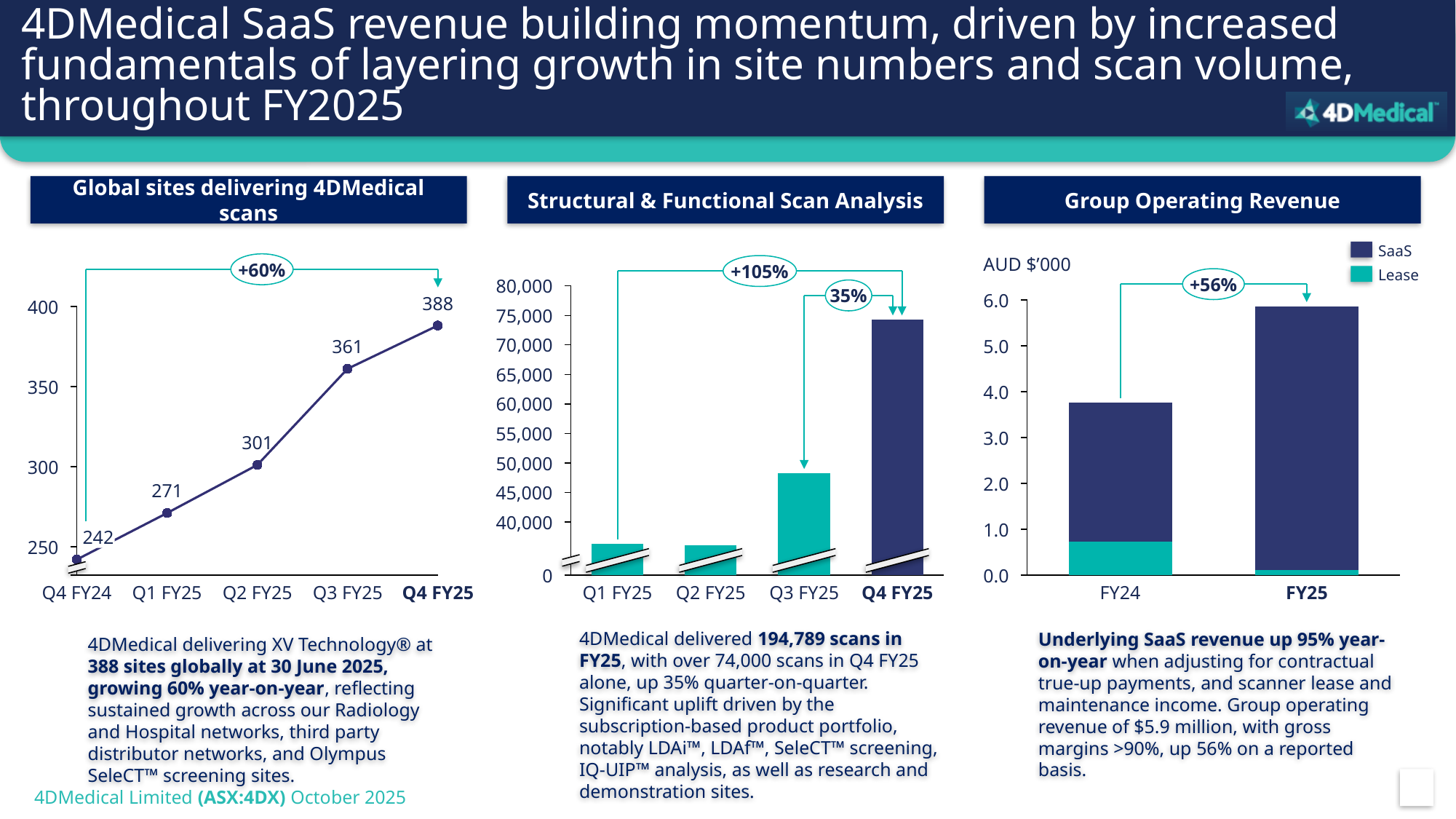
In the 'Global sites delivering 4DMedical scans' chart, what is the difference between the Q4 FY25 and Q4 FY24 values? 146 In the 'Global sites delivering 4DMedical scans' chart, what is the value for Q4 FY25? 388 What kind of chart is the 'Structural & Functional Scan Analysis' chart? bar chart In the 'Global sites delivering 4DMedical scans' chart, how many data points are plotted? 5 In the 'Global sites delivering 4DMedical scans' chart, do the values rise or fall from Q4 FY24 to Q4 FY25? rise In the 'Global sites delivering 4DMedical scans' chart, which quarter has the lowest value? Q4 FY24 In the 'Group Operating Revenue' chart, is the total for FY25 greater or less than 5.0? greater In the 'Structural & Functional Scan Analysis' chart, which quarter has the highest value? Q4 FY25 In the 'Structural & Functional Scan Analysis' chart, is the value for Q4 FY25 greater or less than 70,000? greater How many series does the legend of the 'Group Operating Revenue' chart list? 2 What percentage change is annotated between FY24 and FY25 in the 'Group Operating Revenue' chart? +56% In the 'Global sites delivering 4DMedical scans' chart, what is the value for Q4 FY24? 242